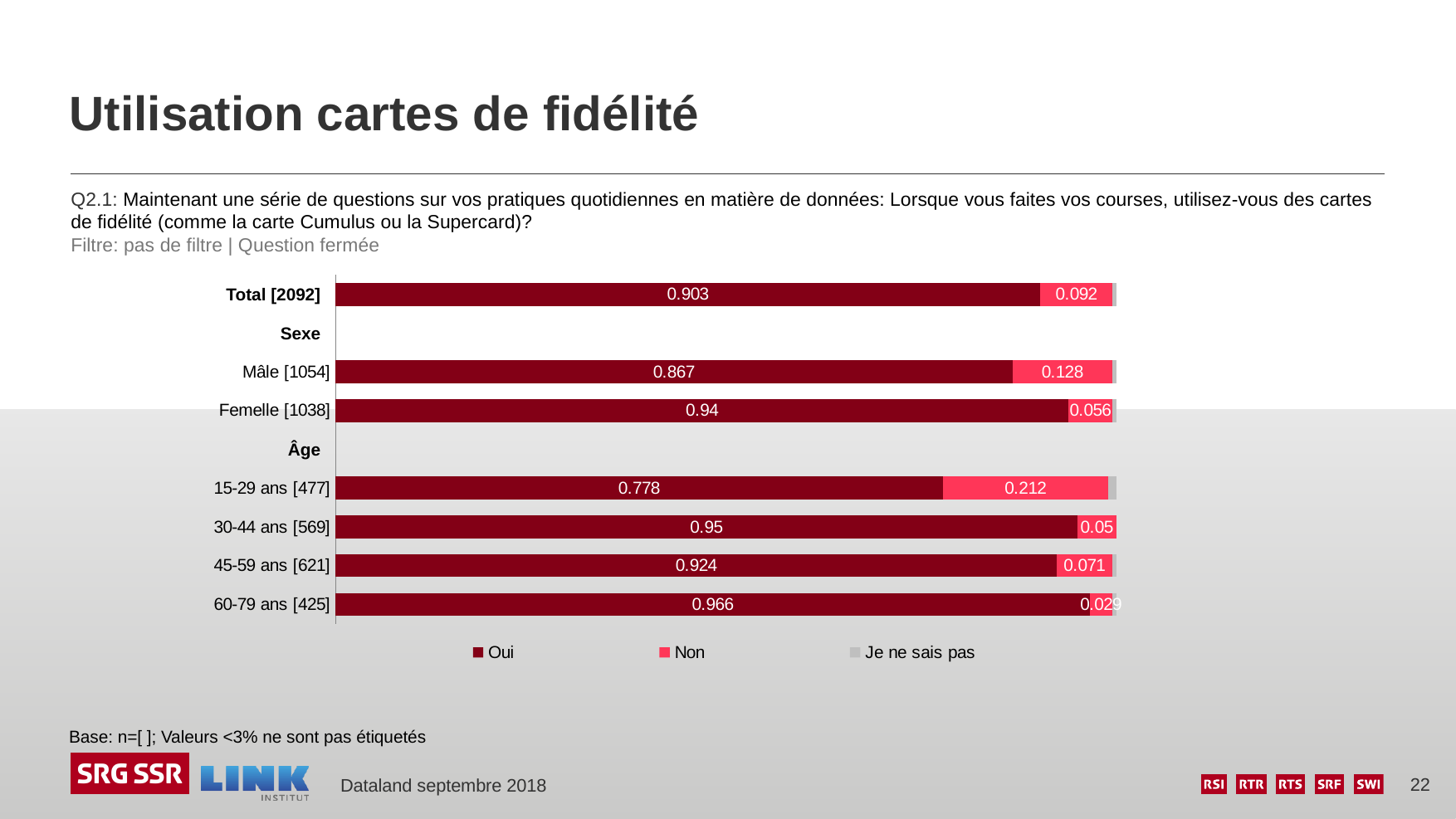
What is the 'Non' value for Mâle [1054]? 0.128 What is the difference between the 'Oui' values for Femelle [1038] and Mâle [1054]? 0.073 How many categories have bars plotted in the chart? 7 What is the 'Oui' value for Total [2092]? 0.903 What kind of chart is shown on the slide? Stacked bar chart How many series does the legend list? 3 What is the 'Non' value for 15-29 ans [477]? 0.212 Which has a larger 'Non' value, 45-59 ans [621] or 30-44 ans [569]? 45-59 ans [621] Which category has the lowest 'Oui' value? 15-29 ans [477] Which category has the highest 'Oui' value? 60-79 ans [425] What is the 'Oui' value for Femelle [1038]? 0.94 Which legend entry is shown in grey? Je ne sais pas